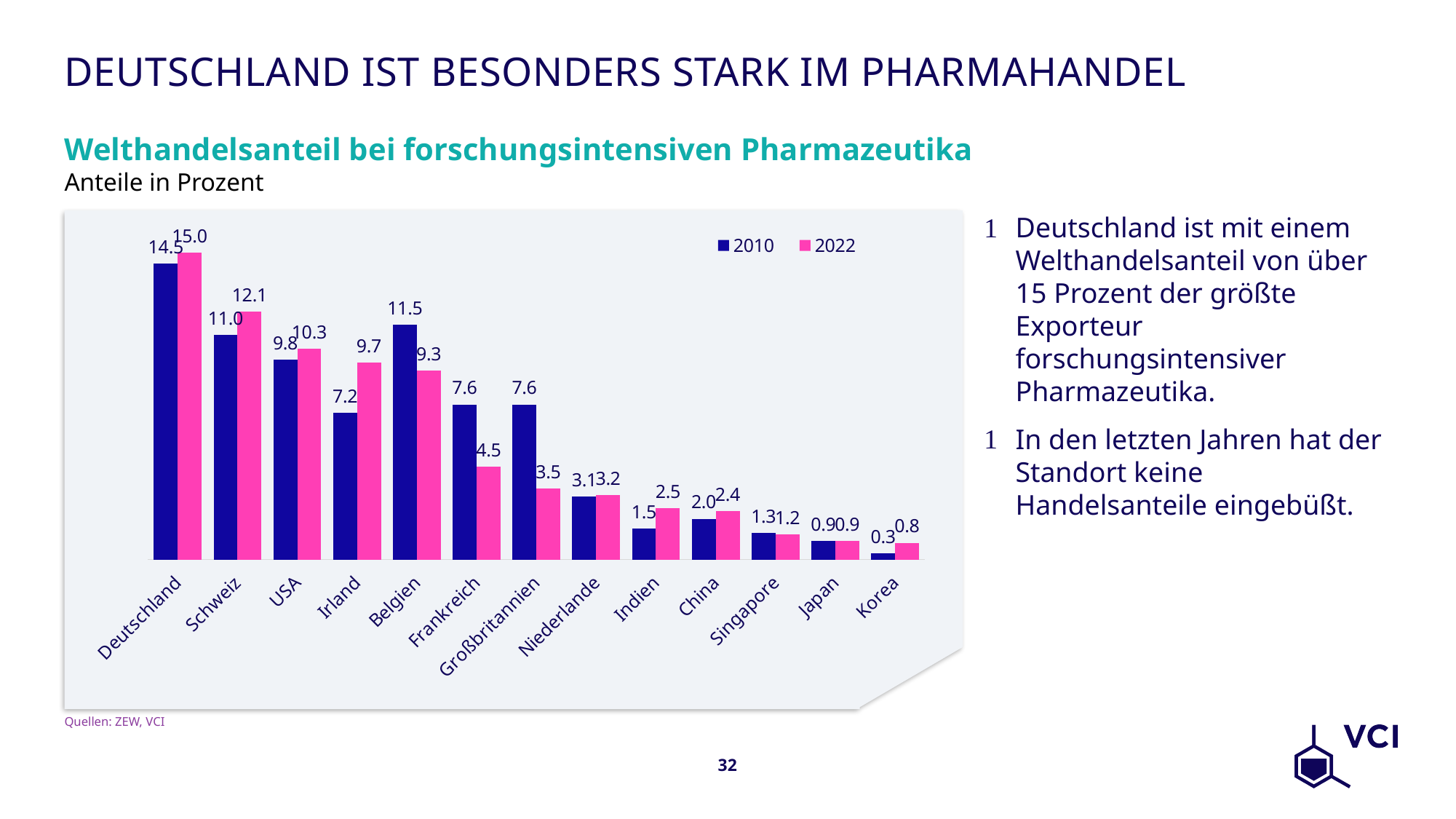
What was Deutschland's world trade share in 2022? 15.0 By how much did Frankreich's share change from 2010 to 2022? It decreased by 3.1 (from 7.6 to 4.5) What was Irland's value for 2022? 9.7 What was Belgien's world trade share in 2010? 11.5 Which is larger: Belgien's 2010 value or Schweiz's 2010 value? Belgien's 2010 value How many series does the legend list? 2 What kind of chart is shown on the slide? Bar chart What is the difference between Deutschland's 2022 value and Schweiz's 2022 value? 2.9 Which colour represents the year 2022 in the chart? Pink How many countries are shown on the x axis? 13 Which country has the lowest value for 2010? Korea Which country has the highest value for 2022? Deutschland